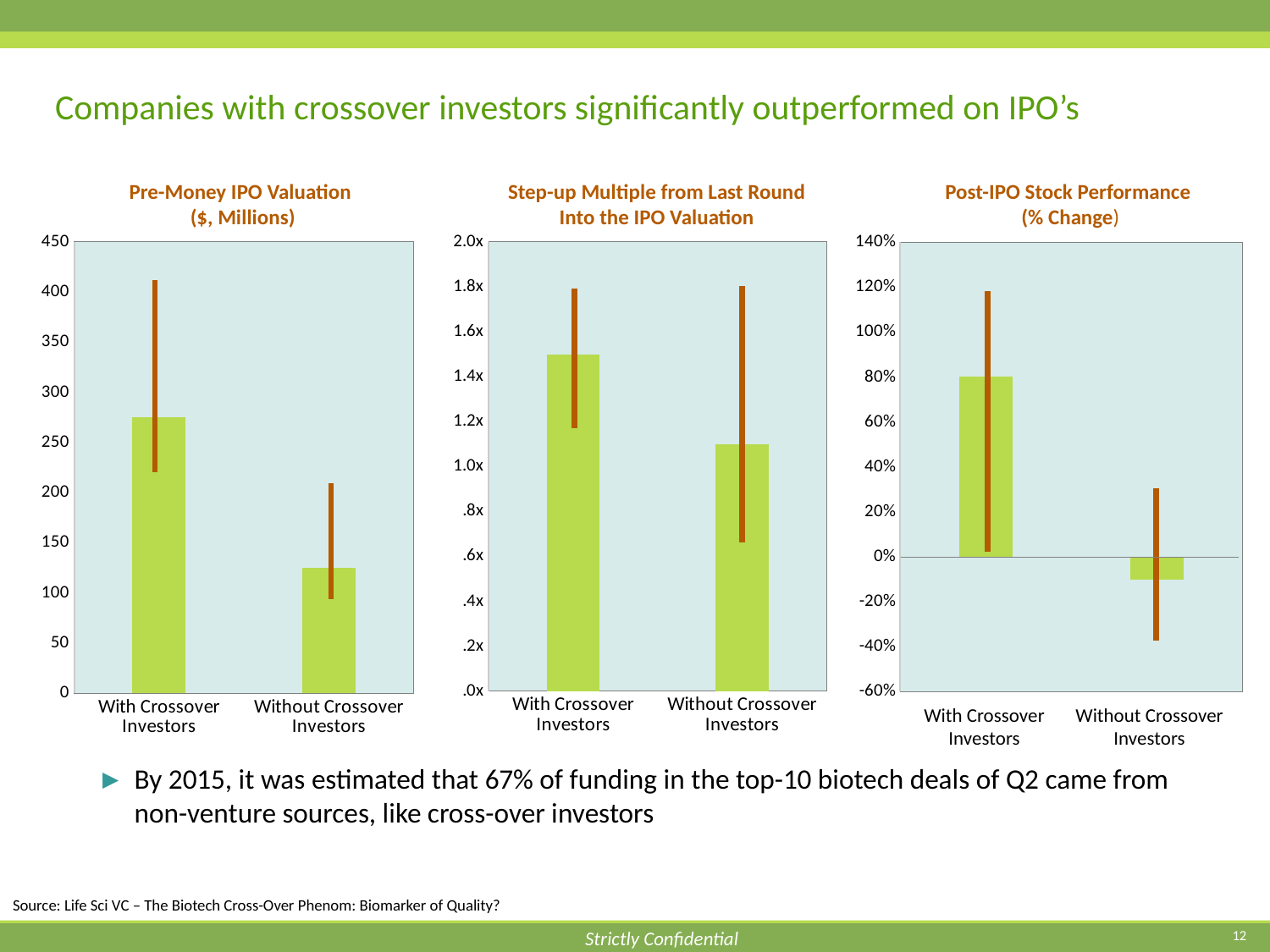
What is the title of the chart on the right of the slide? Post-IPO Stock Performance (% Change) How many categories are shown on the x axis of the Post-IPO Stock Performance chart? 2 In the Step-up Multiple from Last Round Into the IPO Valuation chart, is the value for With Crossover Investors greater or less than 1.4x? greater What kind of chart is the Pre-Money IPO Valuation chart? bar chart In the Post-IPO Stock Performance chart, which category has the highest bar? With Crossover Investors In the Step-up Multiple from Last Round Into the IPO Valuation chart, which category has the lowest bar? Without Crossover Investors In the Pre-Money IPO Valuation chart, is the value for Without Crossover Investors greater or less than 150? less In the Step-up Multiple from Last Round Into the IPO Valuation chart, is the value for Without Crossover Investors greater or less than 1.2x? less In the Pre-Money IPO Valuation chart, which category has the higher bar? With Crossover Investors